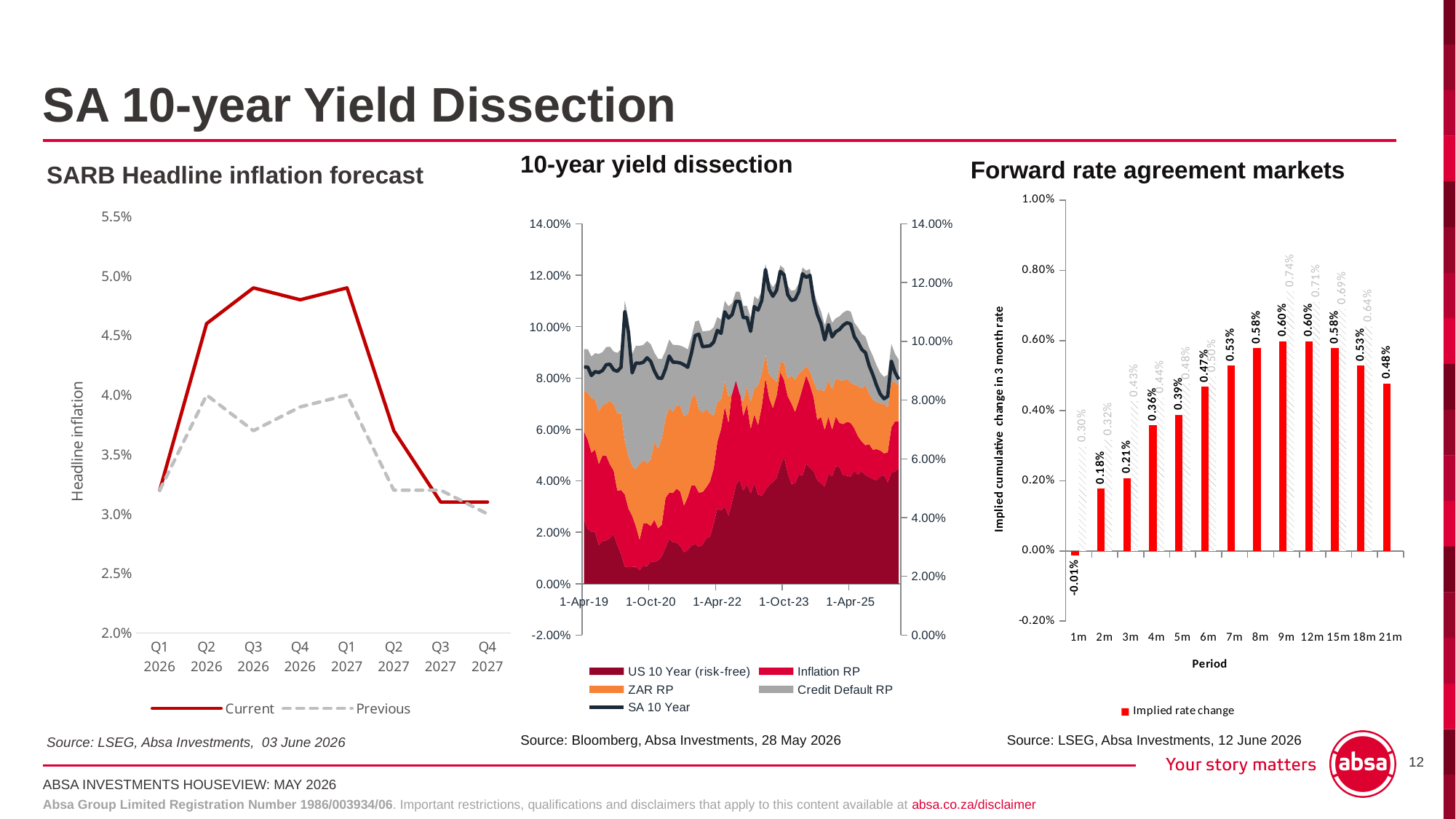
What kind of chart is the SARB Headline inflation forecast chart? Line chart In the Forward rate agreement markets chart, what is the difference between the implied rate change for 9m and for 2m? 0.42% In the Forward rate agreement markets chart, what is the implied rate change for the 1m period? -0.01% What kind of chart is the Forward rate agreement markets chart? Bar chart How many series does the legend of the SARB Headline inflation forecast chart list? 2 In the Forward rate agreement markets chart, which has the larger implied rate change, 4m or 18m? 18m How many series does the legend of the 10-year yield dissection chart list? 5 In the Forward rate agreement markets chart, which period has the lowest implied rate change? 1m In the SARB Headline inflation forecast chart, is the Current value for Q3 2026 greater or less than 4.5%? greater In the SARB Headline inflation forecast chart, which series is higher at Q2 2026, Current or Previous? Current In the Forward rate agreement markets chart, what is the implied rate change for the 8m period? 0.58% How many periods are shown on the x axis of the Forward rate agreement markets chart? 13